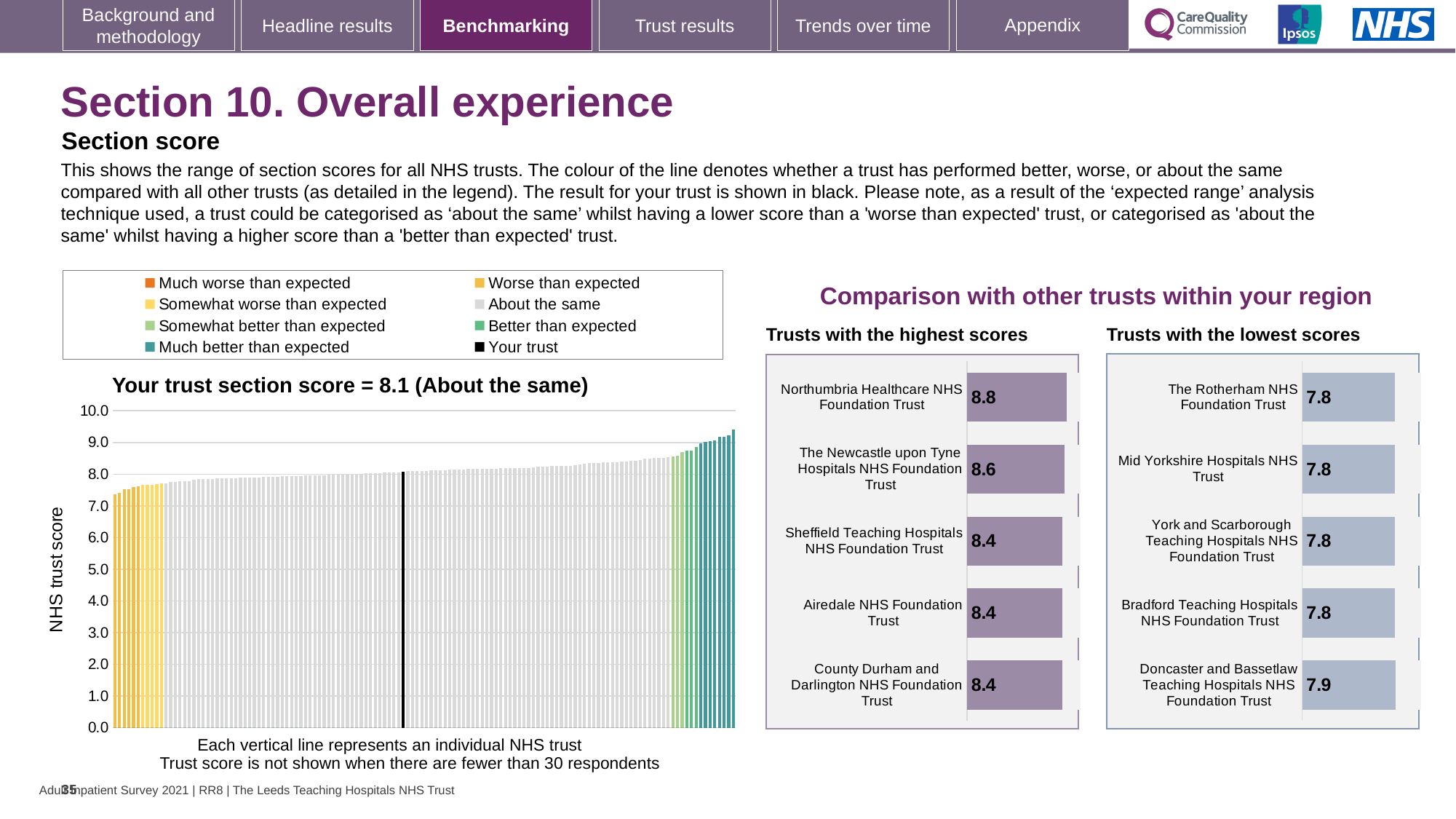
In the main 'Your trust section score' chart, is the value of the leftmost bar greater or less than 8.0? less In the 'Trusts with the highest scores' chart, which has the higher score: The Newcastle upon Tyne Hospitals NHS Foundation Trust or Sheffield Teaching Hospitals NHS Foundation Trust? The Newcastle upon Tyne Hospitals NHS Foundation Trust In the 'Trusts with the highest scores' chart, what is the score for Northumbria Healthcare NHS Foundation Trust? 8.8 What kind of chart is the main 'Your trust section score' chart? Bar chart In the 'Trusts with the lowest scores' chart, what is the score for Doncaster and Bassetlaw Teaching Hospitals NHS Foundation Trust? 7.9 In the 'Trusts with the lowest scores' chart, which trust has the highest score? Doncaster and Bassetlaw Teaching Hospitals NHS Foundation Trust In the 'Trusts with the highest scores' chart, which trust has the highest score? Northumbria Healthcare NHS Foundation Trust How many trusts are listed in the 'Trusts with the lowest scores' chart? 5 How many entries does the legend above the main 'Your trust section score' chart list? 8 In the main chart 'Your trust section score', what is the section score for your trust? 8.1 In the 'Trusts with the highest scores' chart, what is the difference between the scores of Northumbria Healthcare NHS Foundation Trust and The Newcastle upon Tyne Hospitals NHS Foundation Trust? 0.2 In the main 'Your trust section score' chart, do the trust scores rise or fall from left to right along the x axis? Rise